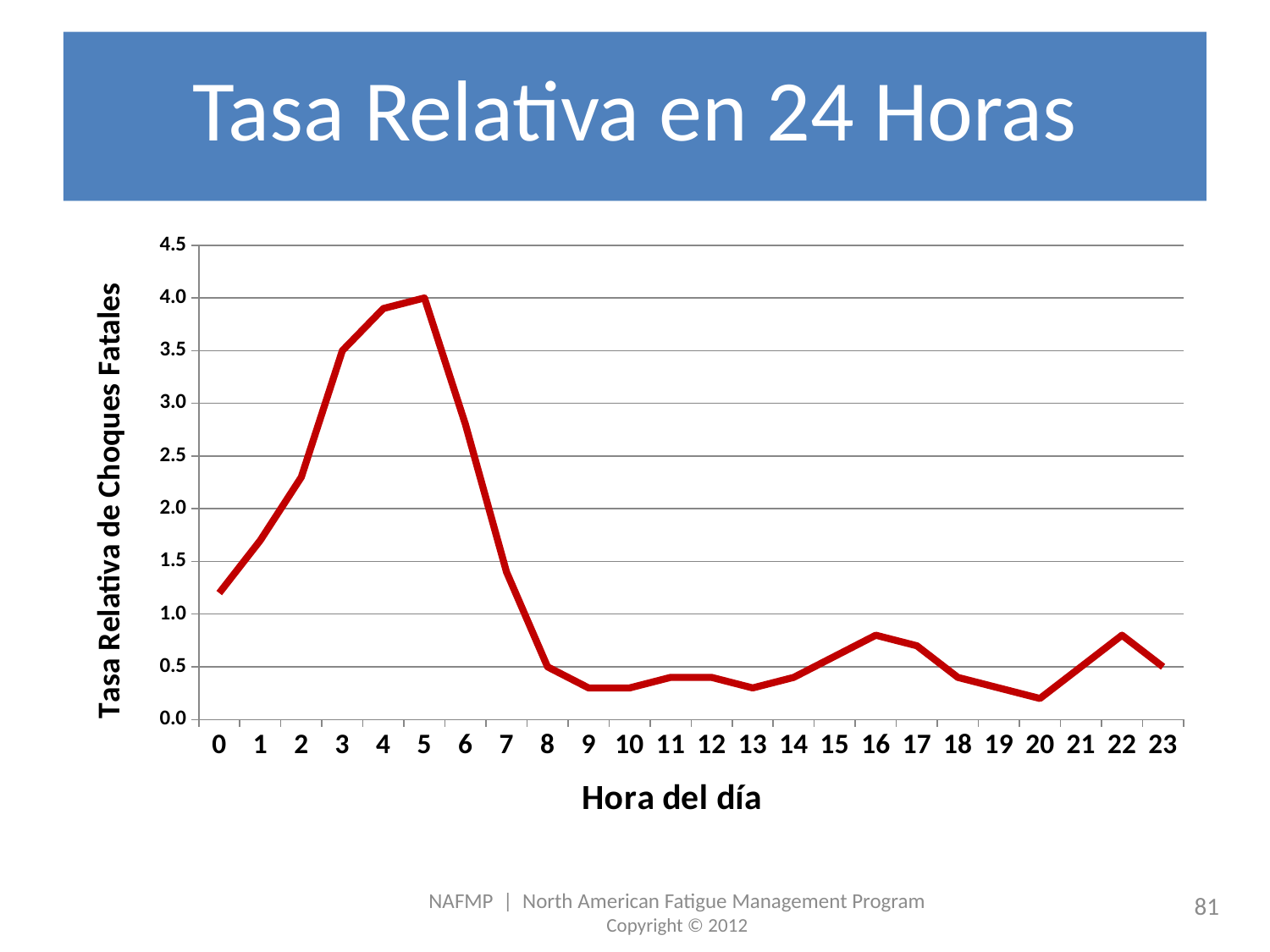
Does the relative rate rise or fall between hour 5 and hour 9? fall What is the label of the x axis? Hora del día At which hour of the day is the relative rate of fatal crashes lowest? 20 What kind of chart is shown on the slide? line chart Is the value for hour 4 greater or less than 3.5? greater Which hour has a higher relative rate, hour 2 or hour 16? 2 What is the relative rate of fatal crashes at hour 5? 4.0 What is the relative rate of fatal crashes at hour 8? 0.5 At which hour of the day is the relative rate of fatal crashes highest? 5 How many hours (data points) are plotted along the x axis? 24 Is the value for hour 12 greater or less than 1.0? less What is the title of the chart? Tasa Relativa en 24 Horas